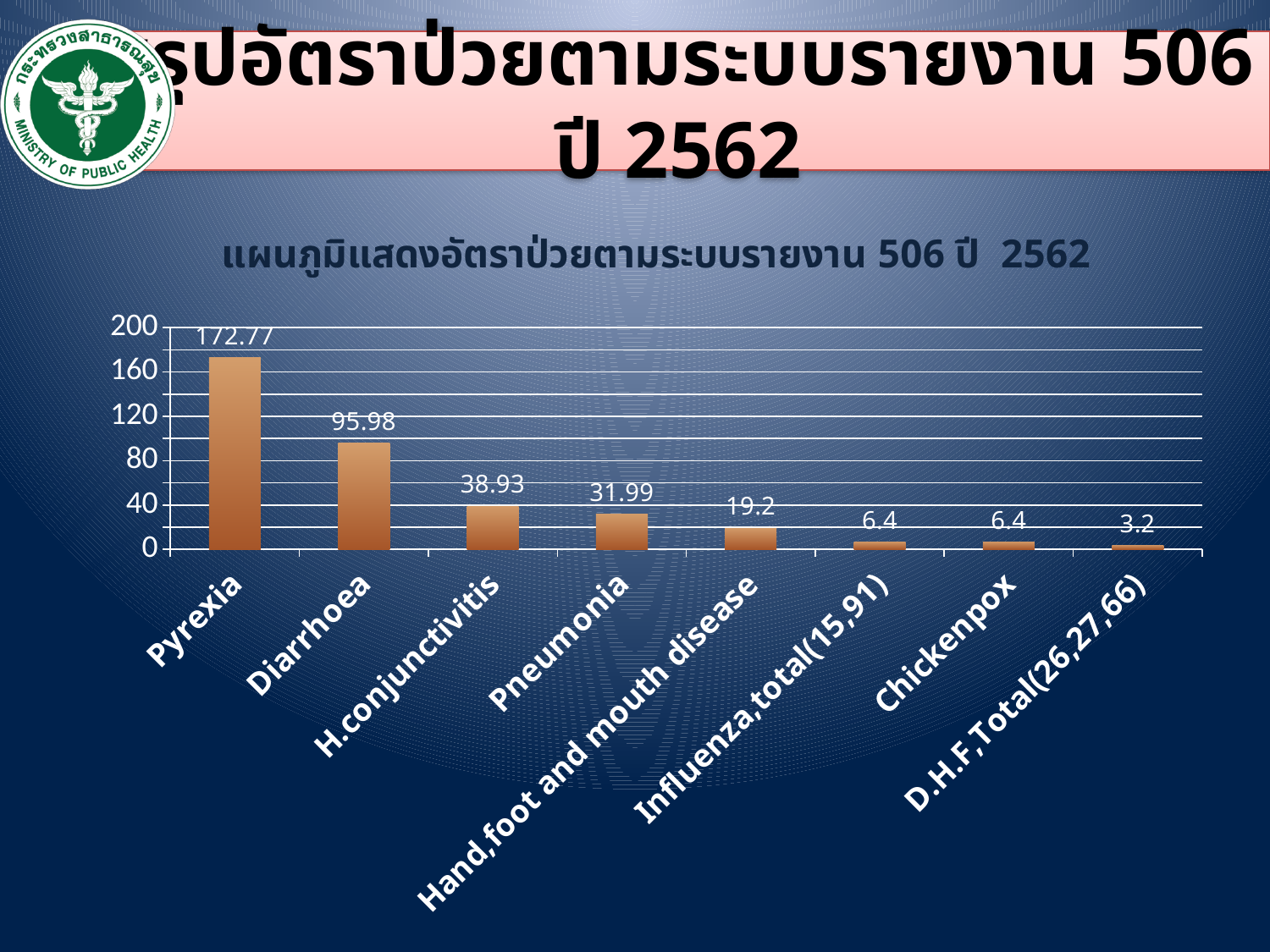
Which category has the lowest value? D.H.F,Total(26,27,66) What is the value for Hand,foot and mouth disease? 19.2 What is the value for Pyrexia? 172.77 Which is larger, the value for H.conjunctivitis or the value for Pneumonia? H.conjunctivitis Which category has the highest value? Pyrexia What is the difference between the values for Pyrexia and Diarrhoea? 76.79 What is the value for H.conjunctivitis? 38.93 How many categories are shown on the x axis? 8 What is the value for Diarrhoea? 95.98 What is the value for Pneumonia? 31.99 What kind of chart is shown on the slide? Bar chart Is the value for Diarrhoea greater or less than 80? greater